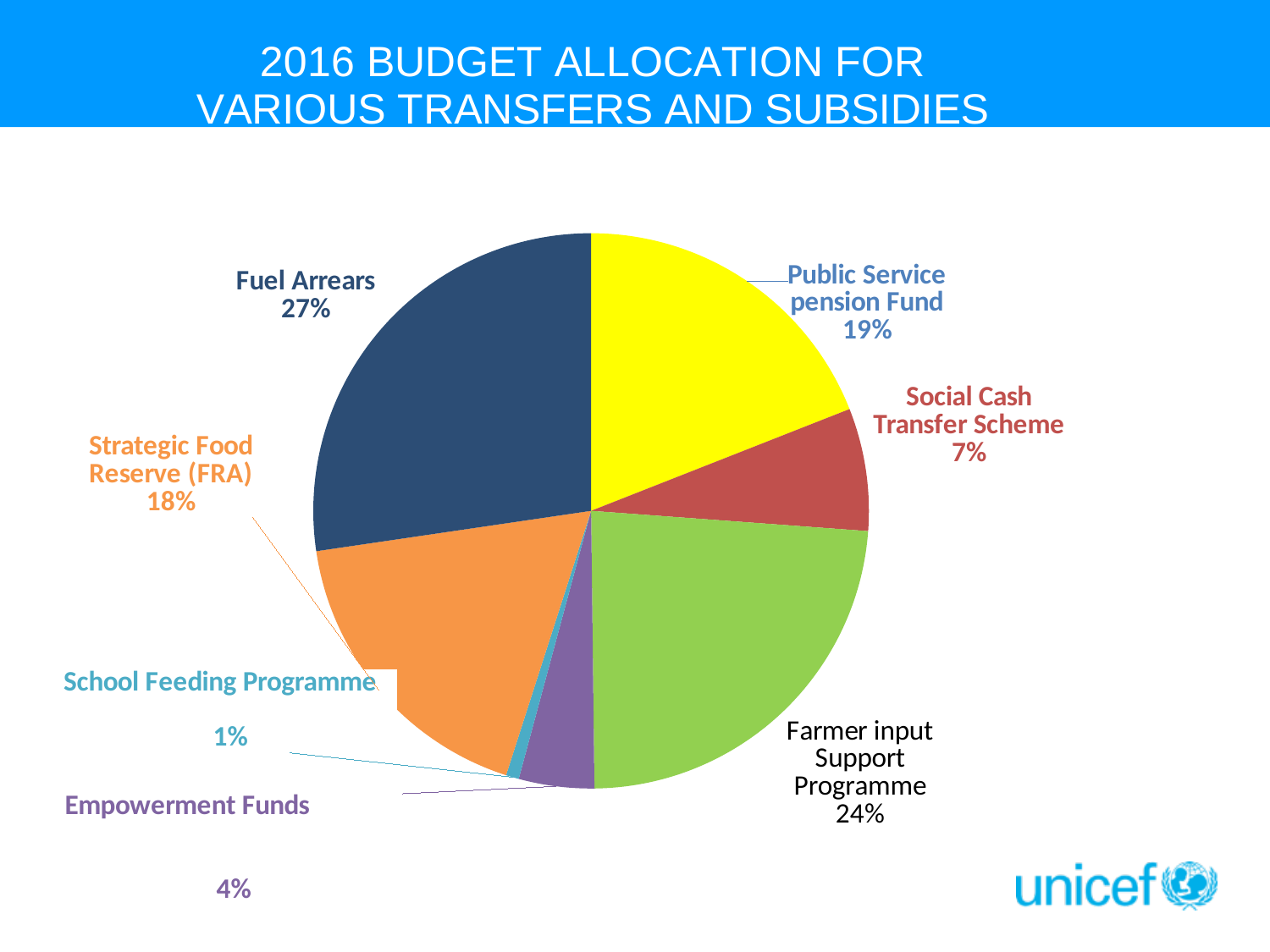
What kind of chart is shown on the slide? Pie chart What is the title of the chart? 2016 BUDGET ALLOCATION FOR VARIOUS TRANSFERS AND SUBSIDIES What share does the Strategic Food Reserve (FRA) receive? 18% Which category receives the largest share of the budget allocation? Fuel Arrears What share of the 2016 budget allocation goes to Fuel Arrears? 27% What percentage is allocated to the Farmer input Support Programme? 24% What percentage is allocated to the Public Service pension Fund? 19% Which receives a larger share, Empowerment Funds or the Social Cash Transfer Scheme? Social Cash Transfer Scheme What is the difference in percentage points between Fuel Arrears and the Farmer input Support Programme? 3 percentage points Which category receives the smallest share of the budget allocation? School Feeding Programme How many categories are shown in the pie chart? 7 What percentage is allocated to the Social Cash Transfer Scheme? 7%